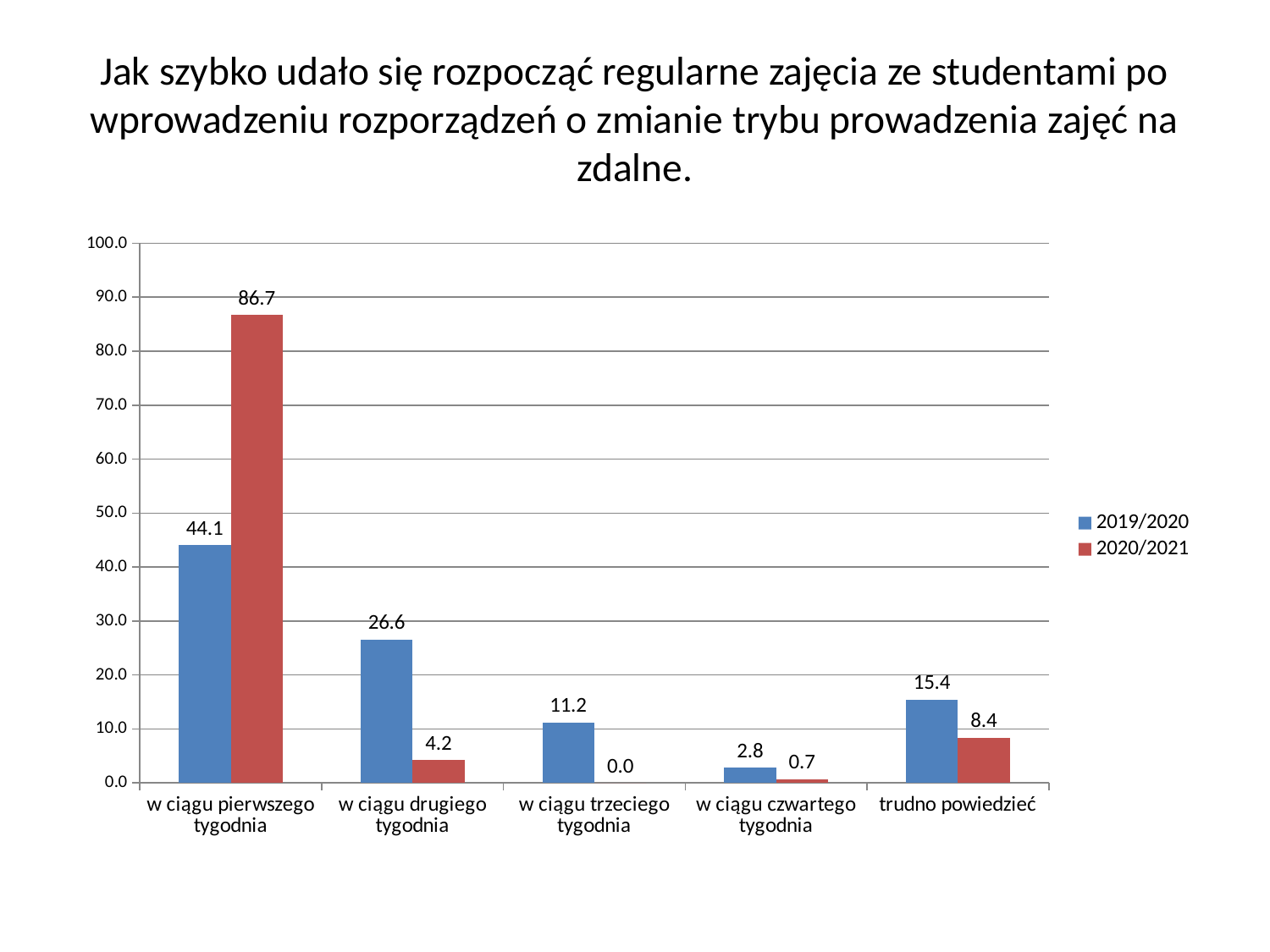
Which category has the highest value for the 2019/2020 series? w ciągu pierwszego tygodnia Which category has the lowest value for the 2020/2021 series? w ciągu trzeciego tygodnia What kind of chart is shown on the slide? bar chart How many series does the legend list? 2 What is the value for 2020/2021 in the category 'w ciągu pierwszego tygodnia'? 86.7 What is the value for 2020/2021 in the category 'trudno powiedzieć'? 8.4 What is the difference between the 2020/2021 and 2019/2020 values in the category 'w ciągu pierwszego tygodnia'? 42.6 Which colour represents the 2020/2021 series? red What is the value for 2019/2020 in the category 'w ciągu drugiego tygodnia'? 26.6 How many categories are shown on the x axis? 5 Which is larger in the category 'trudno powiedzieć': the 2019/2020 value or the 2020/2021 value? 2019/2020 What is the value for 2019/2020 in the category 'w ciągu czwartego tygodnia'? 2.8